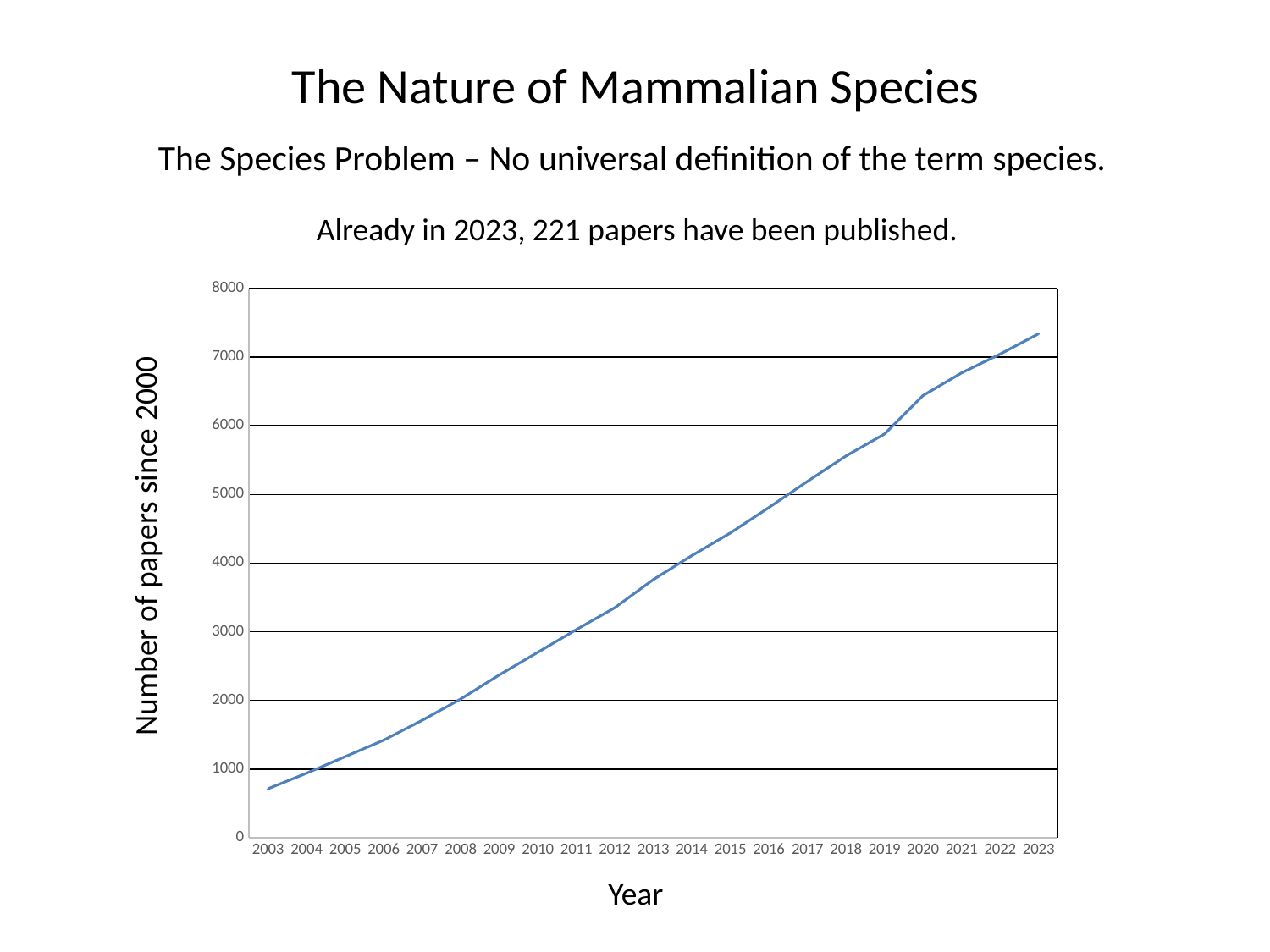
What is the title of the vertical axis of the chart? Number of papers since 2000 Is the value for 2003 greater or less than 1000? less Is the value for 2023 greater or less than 7000? greater Does the number of papers rise or fall from 2003 to 2023? rise Is the value for 2015 greater or less than 4000? greater Which year has the lowest number of papers since 2000? 2003 How many years are plotted along the x axis of the chart? 21 Which year has the highest number of papers since 2000? 2023 Which year has a larger value, 2010 or 2020? 2020 What kind of chart is shown on the slide? line chart